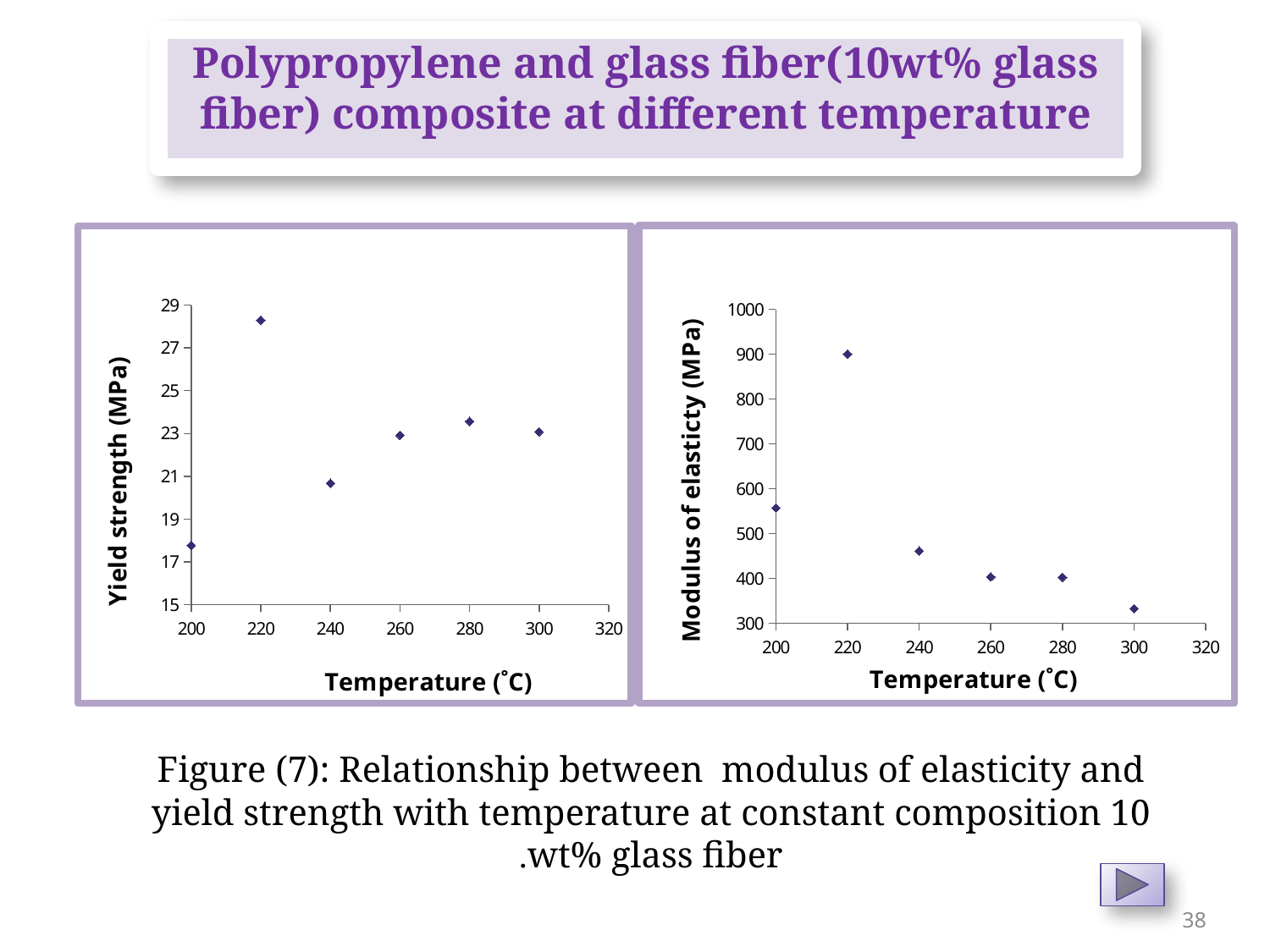
On the right chart (Modulus of elasticity), which has the larger modulus, 200 °C or 240 °C? 200 °C On the left chart (Yield strength), at which temperature is the yield strength highest? 220 What kind of chart is the left chart (Yield strength vs Temperature)? scatter chart On the left chart (Yield strength), is the value at 240 °C greater or less than 21? less What is the y-axis title of the right chart? Modulus of elasticty (MPa) On the right chart (Modulus of elasticity), at which temperature is the modulus lowest? 300 On the right chart (Modulus of elasticity), is the value at 300 °C greater or less than 400? less On the left chart (Yield strength), at which temperature is the yield strength lowest? 200 On the left chart (Yield strength), which has the larger yield strength, 220 °C or 240 °C? 220 °C On the left chart (Yield strength), is the value at 220 °C greater or less than 27? greater How many data points are plotted on the right chart (Modulus of elasticity vs Temperature)? 6 On the right chart (Modulus of elasticity), at which temperature is the modulus highest? 220